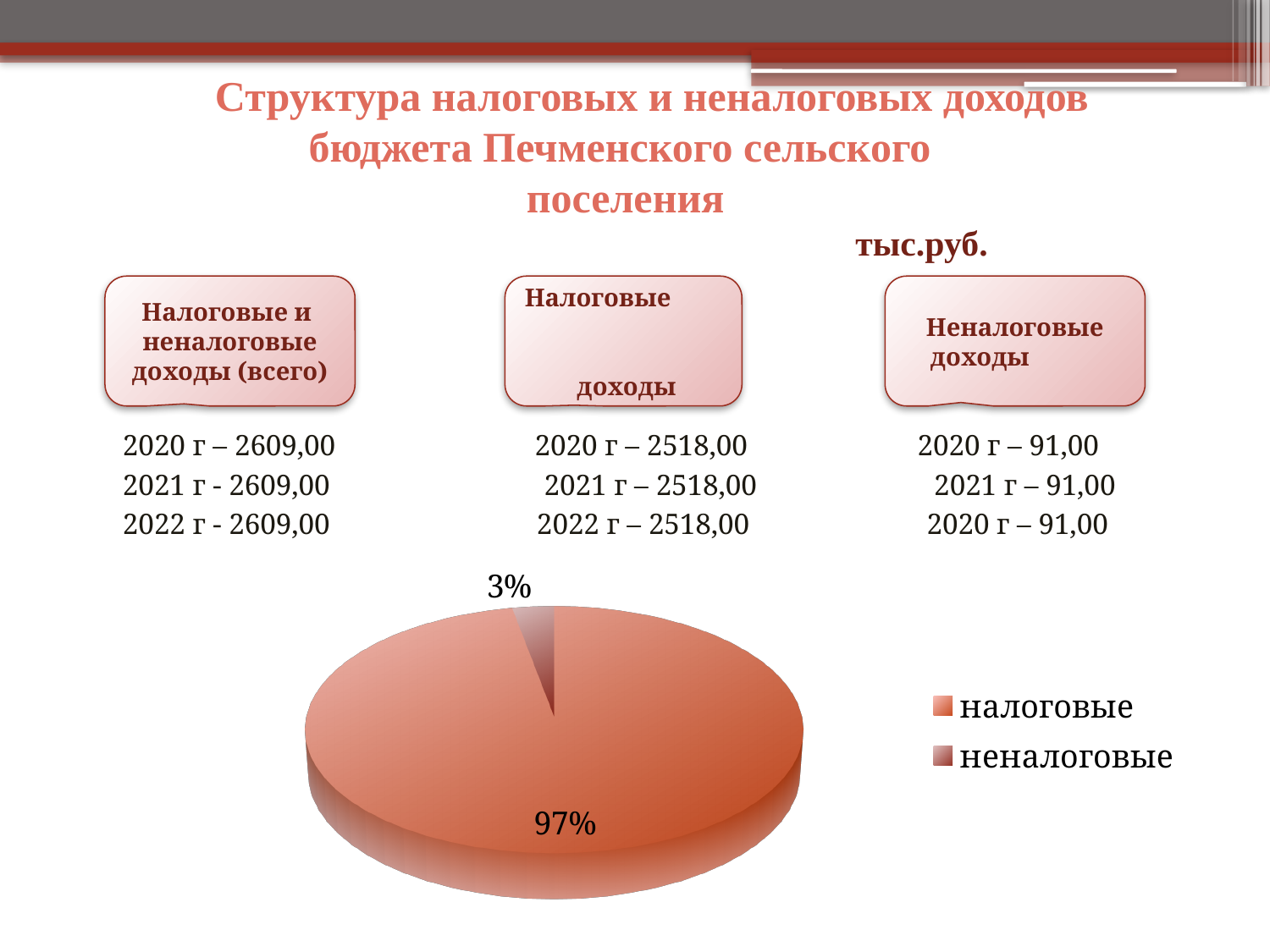
Which slice of the pie chart is the smallest? неналоговые How many entries does the legend of the pie chart list? 2 What is the value printed on the data label of the "неналоговые" slice? 3% What share of the pie does the "налоговые" slice represent? 97% What share of the pie does the "неналоговые" slice represent? 3% What are the two legend entries of the pie chart? налоговые, неналоговые What kind of chart is shown on the slide? pie chart Which is larger in the pie chart, "налоговые" or "неналоговые"? налоговые By how many percentage points does the "налоговые" share exceed the "неналоговые" share? 94 Which slice of the pie chart is the largest? налоговые Where is the legend of the pie chart positioned relative to the pie? to the right How many slices does the pie chart have? 2